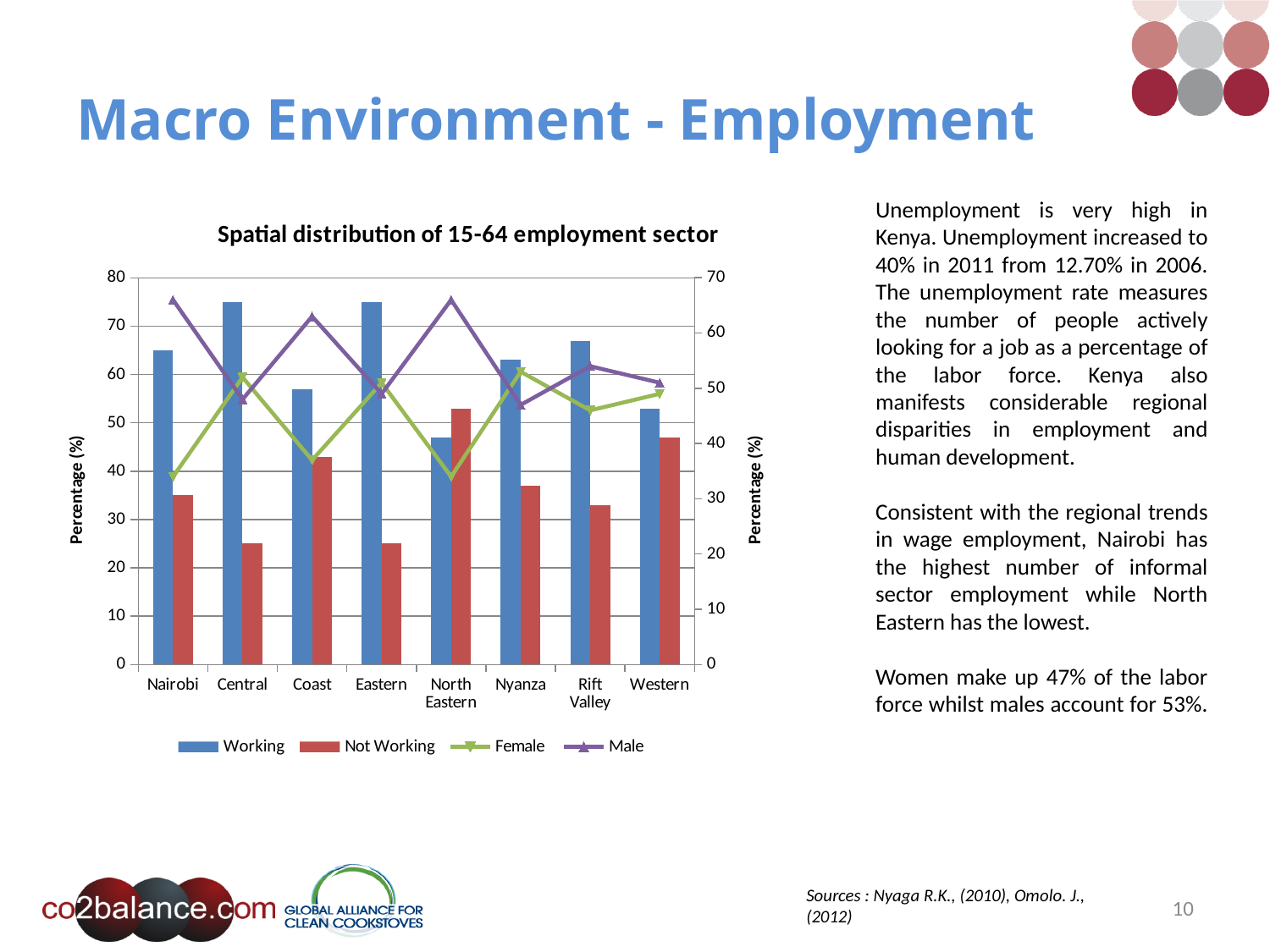
In North Eastern, which is larger: the Working value or the Not Working value? Not Working Is the Working value for Nairobi greater or less than 60? greater How many regions are shown along the x axis of the chart? 8 Is the Not Working value for Western greater or less than 40? greater Which is larger: the Working value for Nairobi or the Working value for Coast? Nairobi What kind of chart is used to plot the Working and Not Working series? bar chart Which region has the highest Not Working value? North Eastern What kind of chart is used to plot the Female and Male series? line chart How many series does the chart legend list? 4 Which region has the lowest Working value? North Eastern Is the Not Working value for Central greater or less than 30? less What is the title of the chart? Spatial distribution of 15-64 employment sector